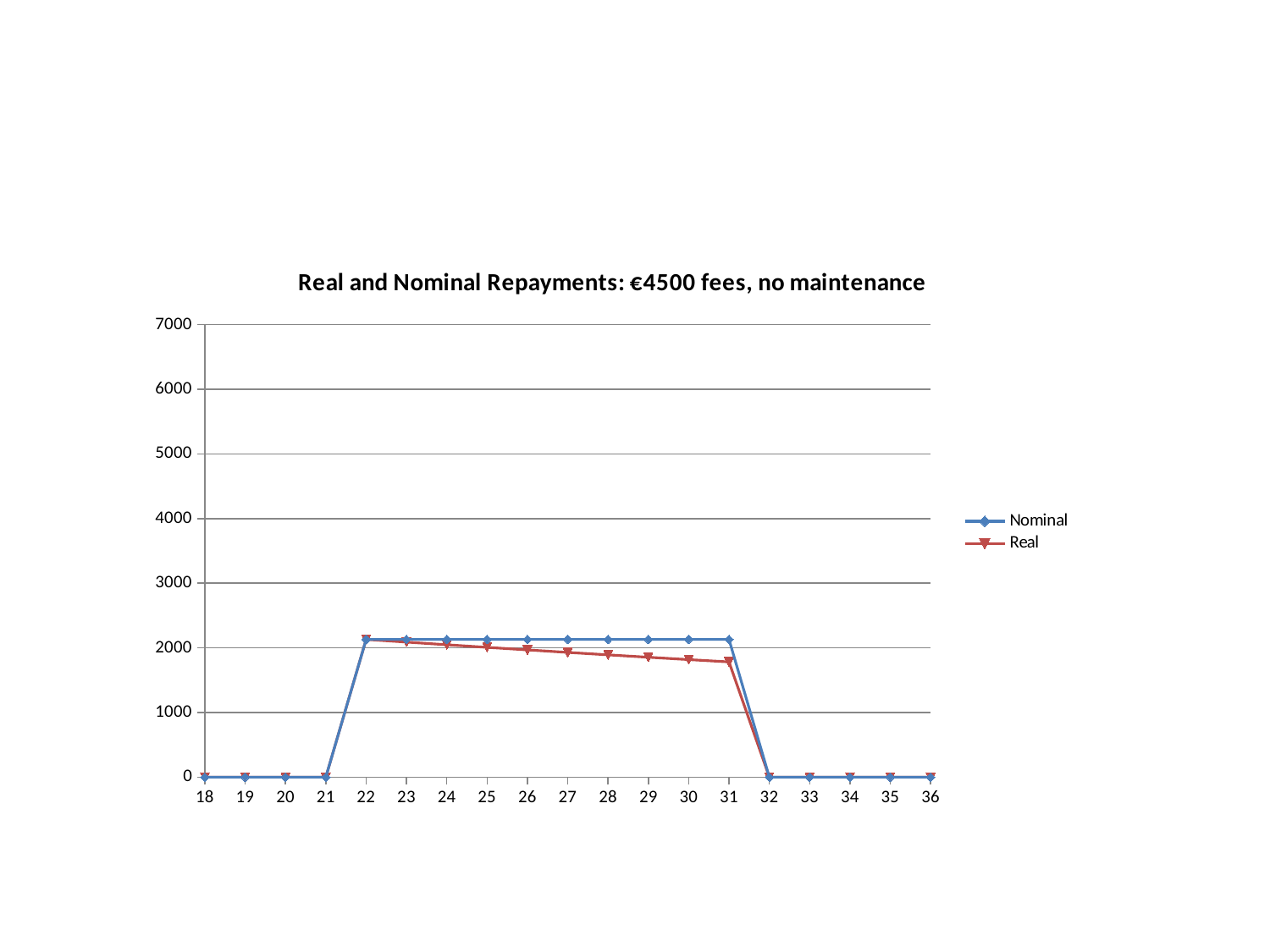
At 30, which series has the larger value, Nominal or Real? Nominal What is the Nominal value at age 18? 0 Does the Real series rise or fall between 22 and 31? fall What is the title of the chart? Real and Nominal Repayments: €4500 fees, no maintenance How many points are plotted along the x axis for each series? 19 What colour is the Real series line? red Is the Real value at 31 greater or less than 2000? less What kind of chart is shown on the slide? line chart What is the Real value at age 36? 0 Is the Nominal value at 25 greater or less than 2000? greater How many series does the legend list? 2 Is the Nominal value at 22 greater or less than 3000? less